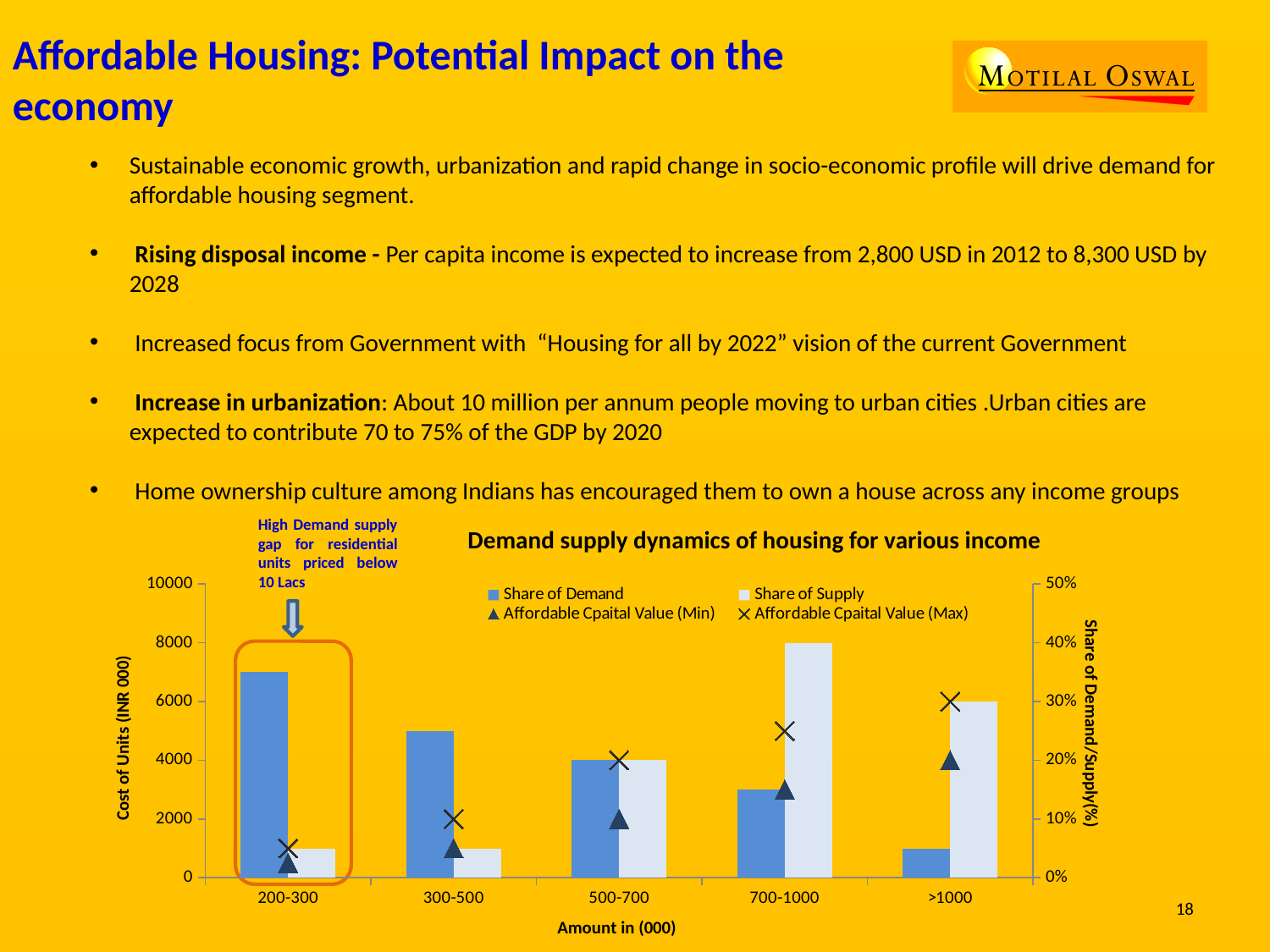
How many income categories are shown on the x axis of the chart? 5 Is the Share of Demand for the 200-300 category greater or less than 30%? greater Which category has the highest Share of Supply? 700-1000 What kind of chart is shown on the slide? A combination chart of bars with scatter markers How many series does the chart legend list? 4 What is the Share of Supply for the 700-1000 category? 40% Does the Share of Demand rise or fall as you move from 200-300 to >1000 along the x axis? Fall For the 200-300 category, which is larger: Share of Demand or Share of Supply? Share of Demand What is the title of the chart on the slide? Demand supply dynamics of housing for various income What is the label of the left vertical axis of the chart? Cost of Units (INR 000) Which category has the lowest Share of Demand? >1000 Which category has the highest Share of Demand? 200-300